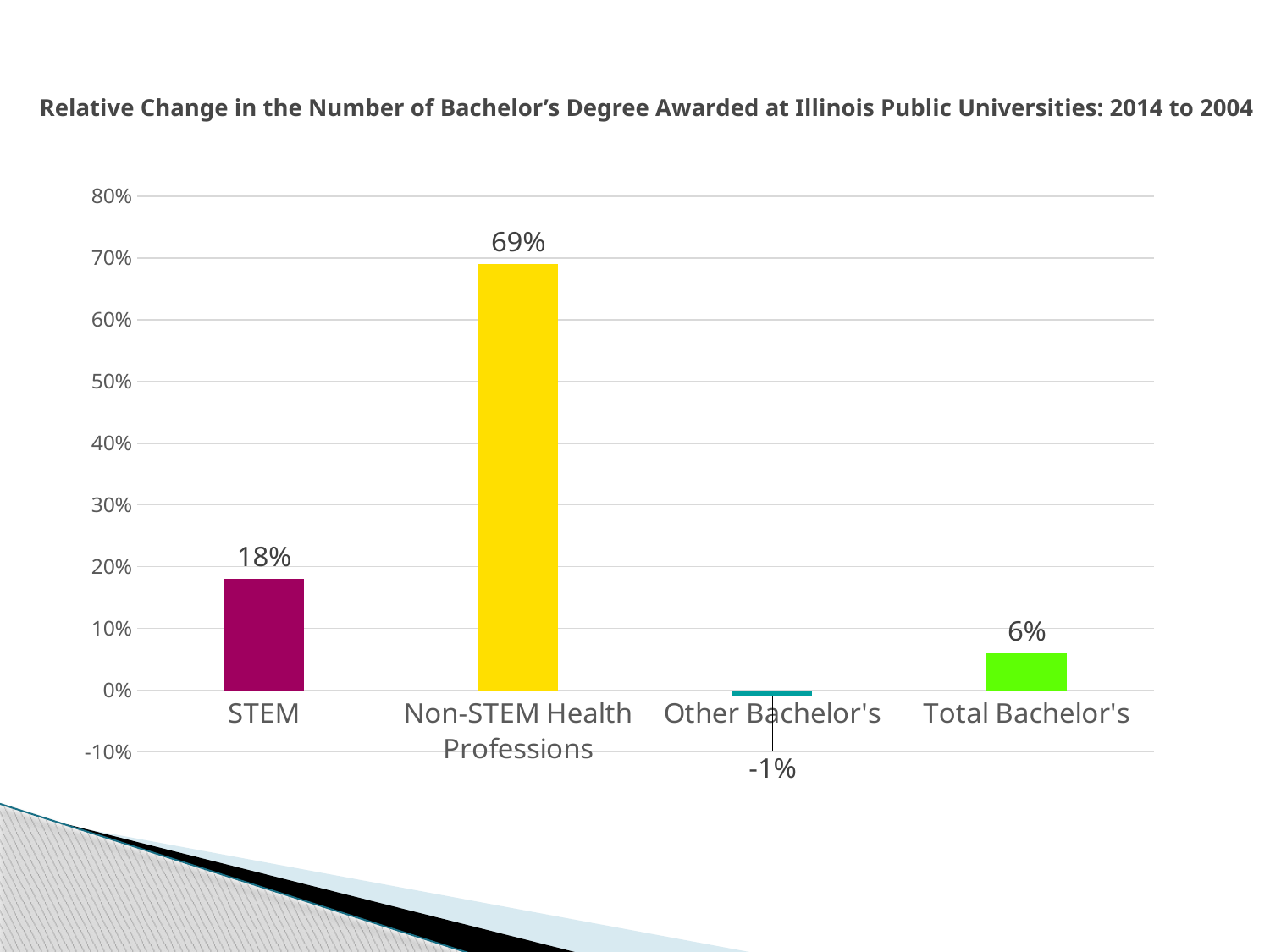
Which is larger, the relative change for STEM or for Total Bachelor's? STEM What kind of chart is shown on the slide? Bar chart What is the difference between the relative change for Non-STEM Health Professions and STEM? 51% What colour is the bar for Non-STEM Health Professions? Yellow Which category has the lowest relative change? Other Bachelor's Is the value for Non-STEM Health Professions greater or less than 60%? greater What is the relative change for Non-STEM Health Professions? 69% Which category has the highest relative change? Non-STEM Health Professions What is the relative change for STEM? 18% How many categories are shown on the chart? 4 What is the relative change for Other Bachelor's? -1% What is the relative change for Total Bachelor's? 6%